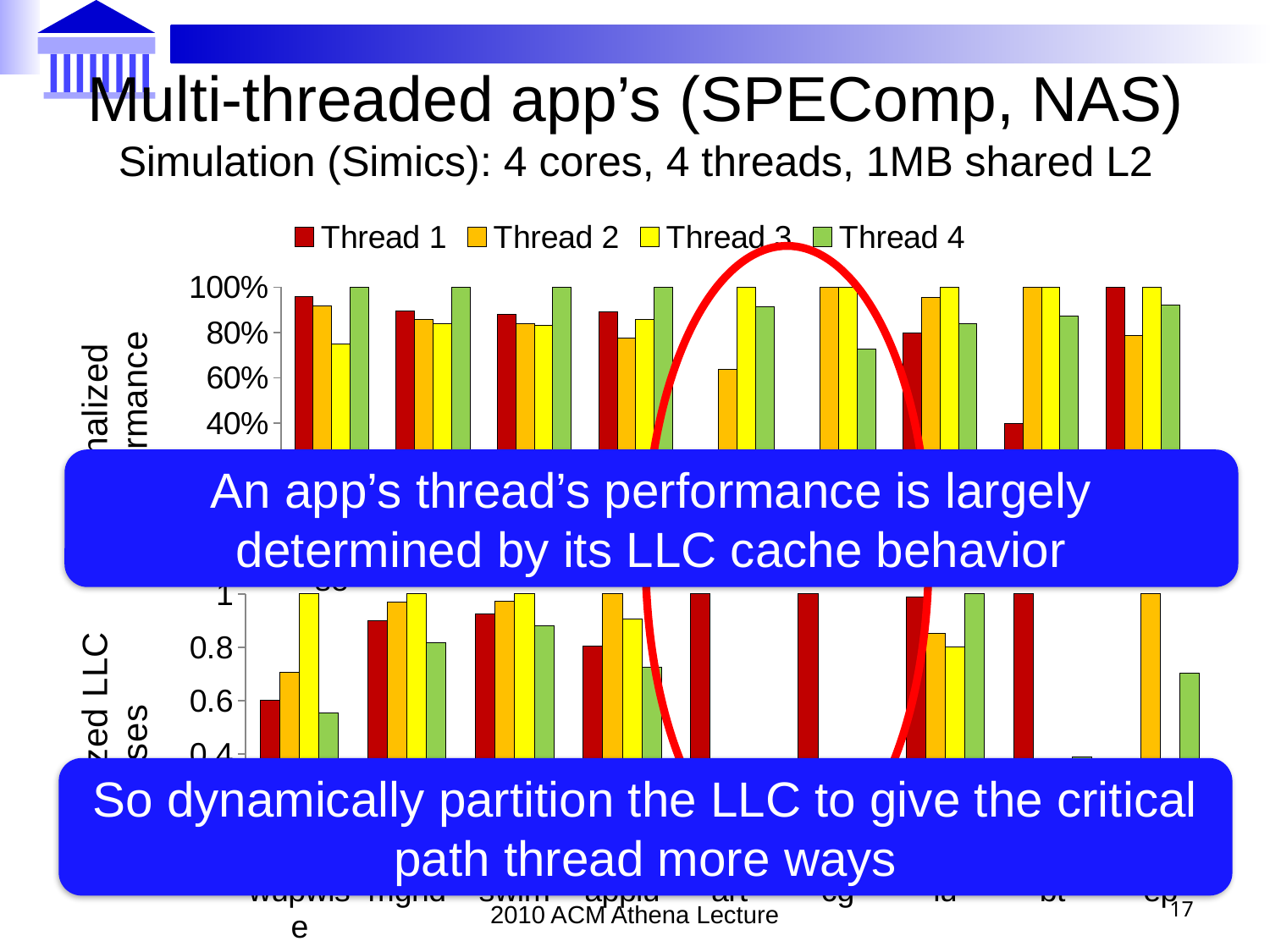
What kind of chart is the top chart on the slide? bar chart In the bottom chart (normalized LLC misses), how many application categories are shown along the x axis? 9 How many series does the legend at the top of the slide list? 4 In the bottom chart, is the value for Thread 2 on wupwise greater or less than 0.6? greater In the bottom chart, is the value for Thread 4 on applu greater or less than 0.8? less In the bottom chart, which is larger for mgrid: the value for Thread 1 or the value for Thread 4? Thread 1 In the bottom chart, which thread has the lowest normalized LLC misses for applu? Thread 4 In the bottom chart, what is the normalized LLC misses value for Thread 3 on wupwise? 1 What are the series names listed in the legend? Thread 1, Thread 2, Thread 3, Thread 4 In the bottom chart, which thread has the highest normalized LLC misses for applu? Thread 2 In the bottom chart, what is the normalized LLC misses value for Thread 1 on art? 1 In the top chart (normalized performance), is the value for Thread 1 in the leftmost group greater or less than 80%? greater